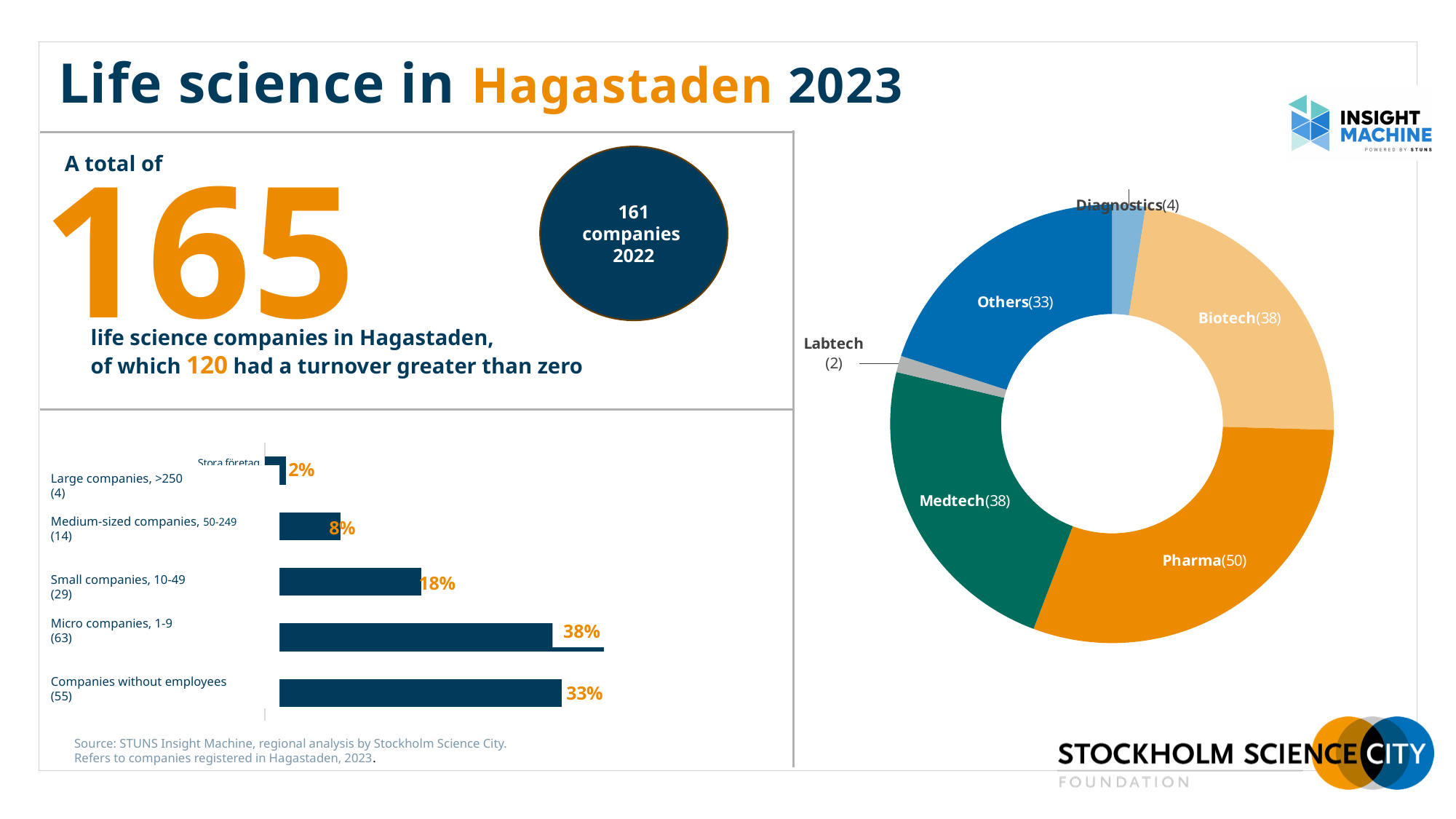
In the donut chart on the right, what is the difference between the number of Pharma companies and the number of Biotech companies? 12 In the bar chart on the left, which company size category has the highest percentage? Micro companies, 1-9 In the bar chart on the left, what percentage is shown for Micro companies, 1-9? 38% In the bar chart on the left, what is the difference in percentage points between Micro companies, 1-9 and Companies without employees? 5 percentage points How many company size categories are shown in the bar chart on the left? 5 In the donut chart on the right, how many companies are in the Pharma segment? 50 In the donut chart on the right, which sector has the largest number of companies? Pharma What kind of chart is the chart on the left showing company sizes? Bar chart What kind of chart is the chart on the right showing sectors? Donut (pie) chart In the bar chart on the left, which company size category has the lowest percentage? Large companies, >250 How many sectors are shown in the donut chart on the right? 6 In the donut chart on the right, which sector has the smallest number of companies? Labtech